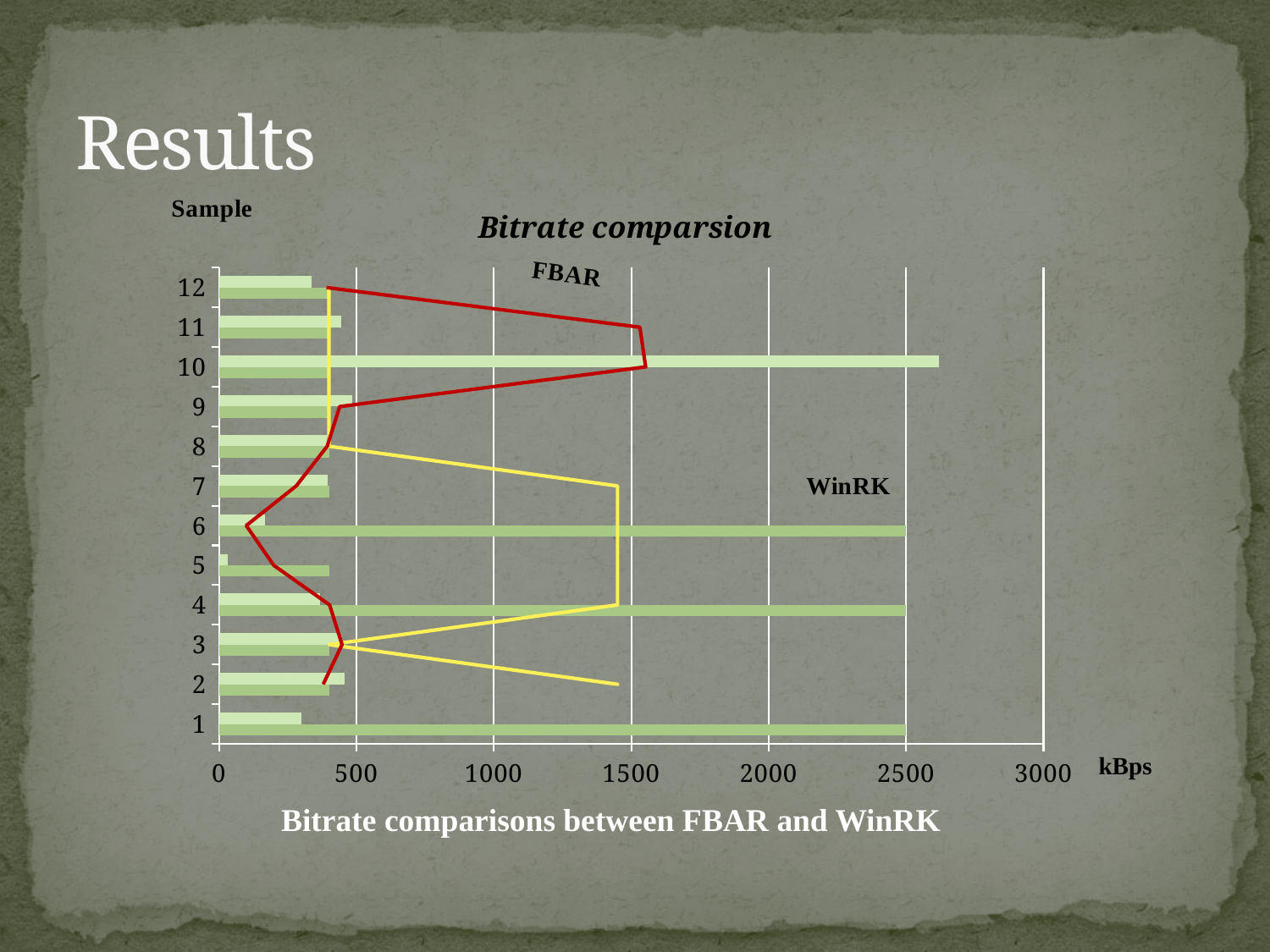
Is the FBAR line value at sample 6 greater or less than 500 kBps? less Is the WinRK line value at sample 8 greater or less than 500 kBps? less Which coloured line on the chart is labelled FBAR? the red line Are the bars for sample 11 greater or less than 500 kBps? less What kind of chart is shown on the slide? bar chart Which sample has the longest bar on the chart? 10 On the FBAR line, which is larger, the value at sample 10 or the value at sample 6? sample 10 What is the title of the chart? Bitrate comparsion How many samples are listed on the vertical axis of the chart? 12 Which has a longer bar, sample 10 or sample 12? sample 10